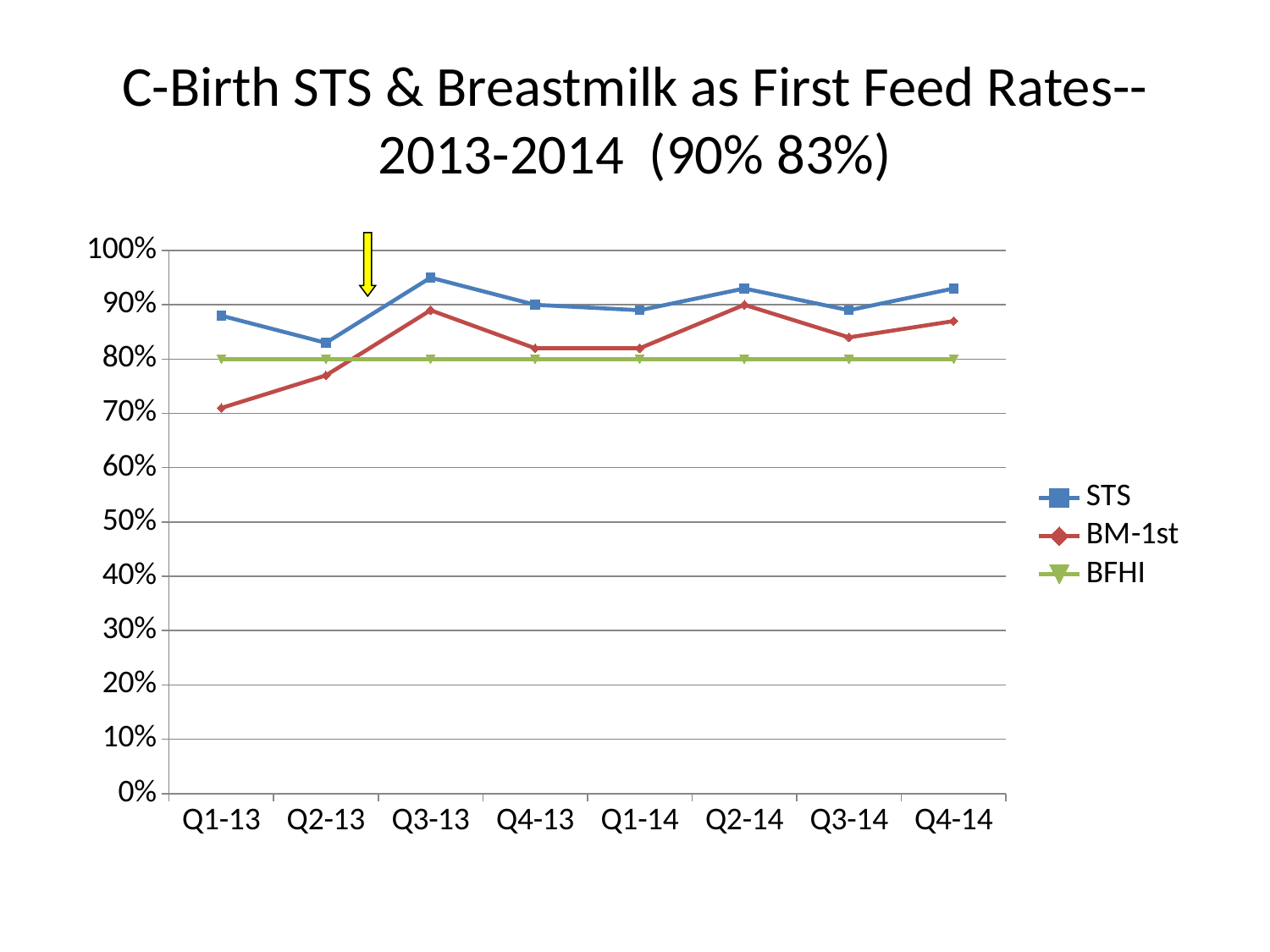
In which quarter does the STS series reach its highest value? Q3-13 How many quarters are plotted along the x axis? 8 What is the value of the BFHI line across all quarters? 80% Does the BFHI line rise, fall, or stay flat from Q1-13 to Q4-14? Stays flat In which quarter is the BM-1st series at its lowest value? Q1-13 Is the BM-1st value for Q2-14 greater or less than 80%? greater Is the STS value for Q3-13 greater or less than 90%? greater Which series is shown with the green line in the legend? BFHI Which series has the higher value in Q1-13, STS or BM-1st? STS How many series does the legend list? 3 What kind of chart is shown on the slide? Line chart Is the BM-1st value for Q1-13 greater or less than 80%? less